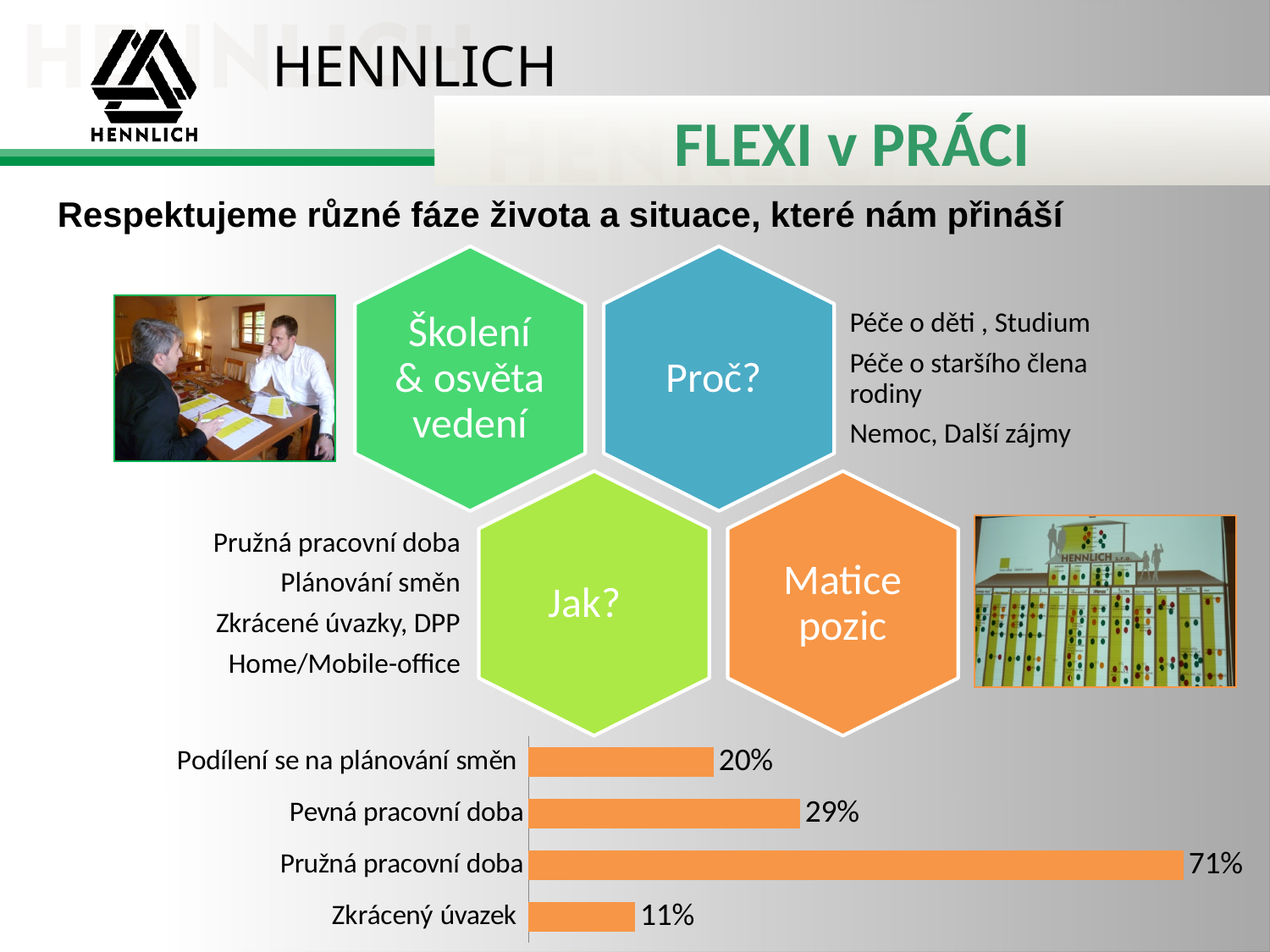
What kind of chart is shown at the bottom of the slide? Bar chart What is the difference between the values for Pružná pracovní doba and Pevná pracovní doba? 42% What is the difference between the values for Podílení se na plánování směn and Zkrácený úvazek? 9% What is the value for Pevná pracovní doba in the bar chart? 29% Which category has the highest value in the bar chart? Pružná pracovní doba What colour are the bars in the chart? Orange Which is larger: the value for Pevná pracovní doba or Podílení se na plánování směn? Pevná pracovní doba Which category has the lowest value in the bar chart? Zkrácený úvazek What is the value for Pružná pracovní doba in the bar chart? 71% What is the value for Podílení se na plánování směn in the bar chart? 20% What is the value for Zkrácený úvazek in the bar chart? 11% How many categories are shown in the bar chart? 4